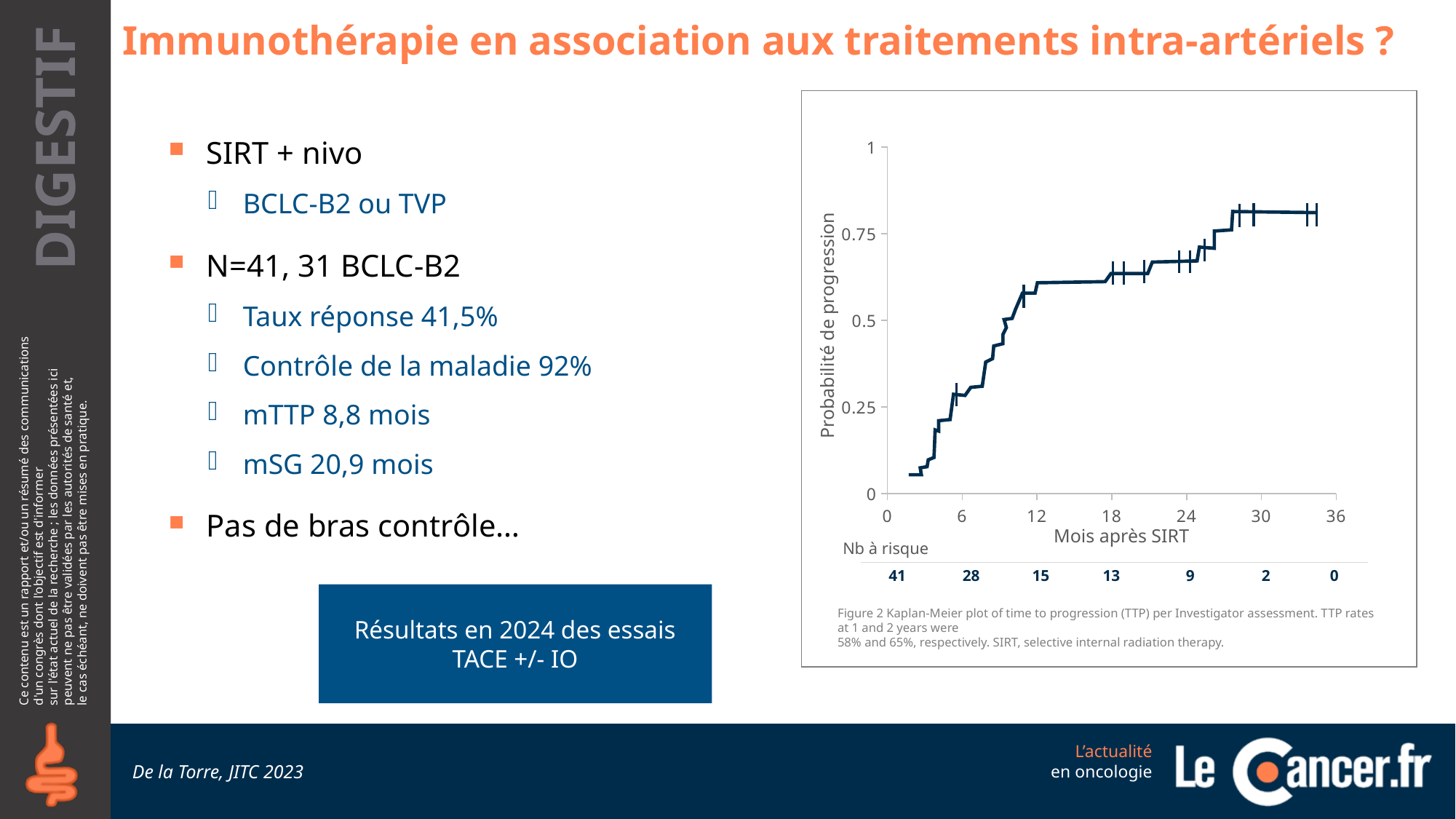
Is the probability of progression at 6 months greater or less than 0.5? less What is the difference between the number at risk at 0 months and at 6 months? 13 Is the probability of progression at 12 months greater or less than 0.5? greater What is the label of the y axis of the chart? Probabilité de progression What kind of chart is shown on the slide? Line chart (Kaplan-Meier plot) In the number-at-risk table below the chart, how many patients are at risk at 24 months? 9 According to the figure caption, what were the TTP rates at 1 and 2 years? 58% and 65% Does the probability of progression curve rise or fall as months after SIRT increase? Rises In the number-at-risk table below the chart, how many patients are at risk at 12 months? 15 What is the label of the x axis of the chart? Mois après SIRT How many time points are listed in the number-at-risk table below the chart? 7 In the number-at-risk table below the chart, how many patients are at risk at 0 months? 41